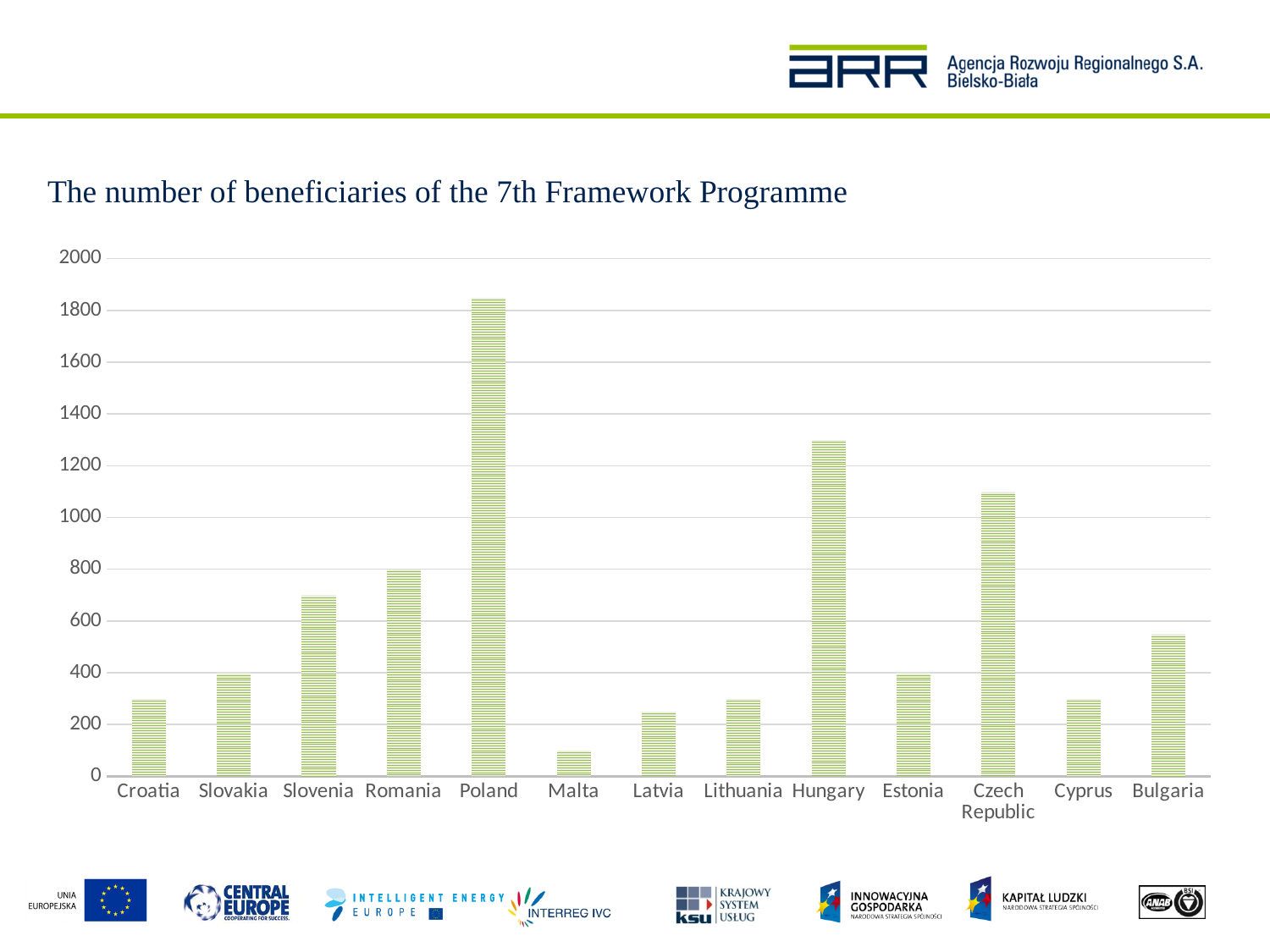
Which country has the lowest number of beneficiaries? Malta Which has more beneficiaries, Bulgaria or Estonia? Bulgaria Which country has the highest number of beneficiaries? Poland Is the value for Malta greater or less than 200? less Which has more beneficiaries, Hungary or Czech Republic? Hungary Is the value for Hungary greater or less than 1200? greater How many countries are shown on the x axis of the chart? 13 What is the title of the chart? The number of beneficiaries of the 7th Framework Programme Is the value for Czech Republic greater or less than 1000? greater Which has more beneficiaries, Romania or Slovenia? Romania What kind of chart is shown on the slide? bar chart